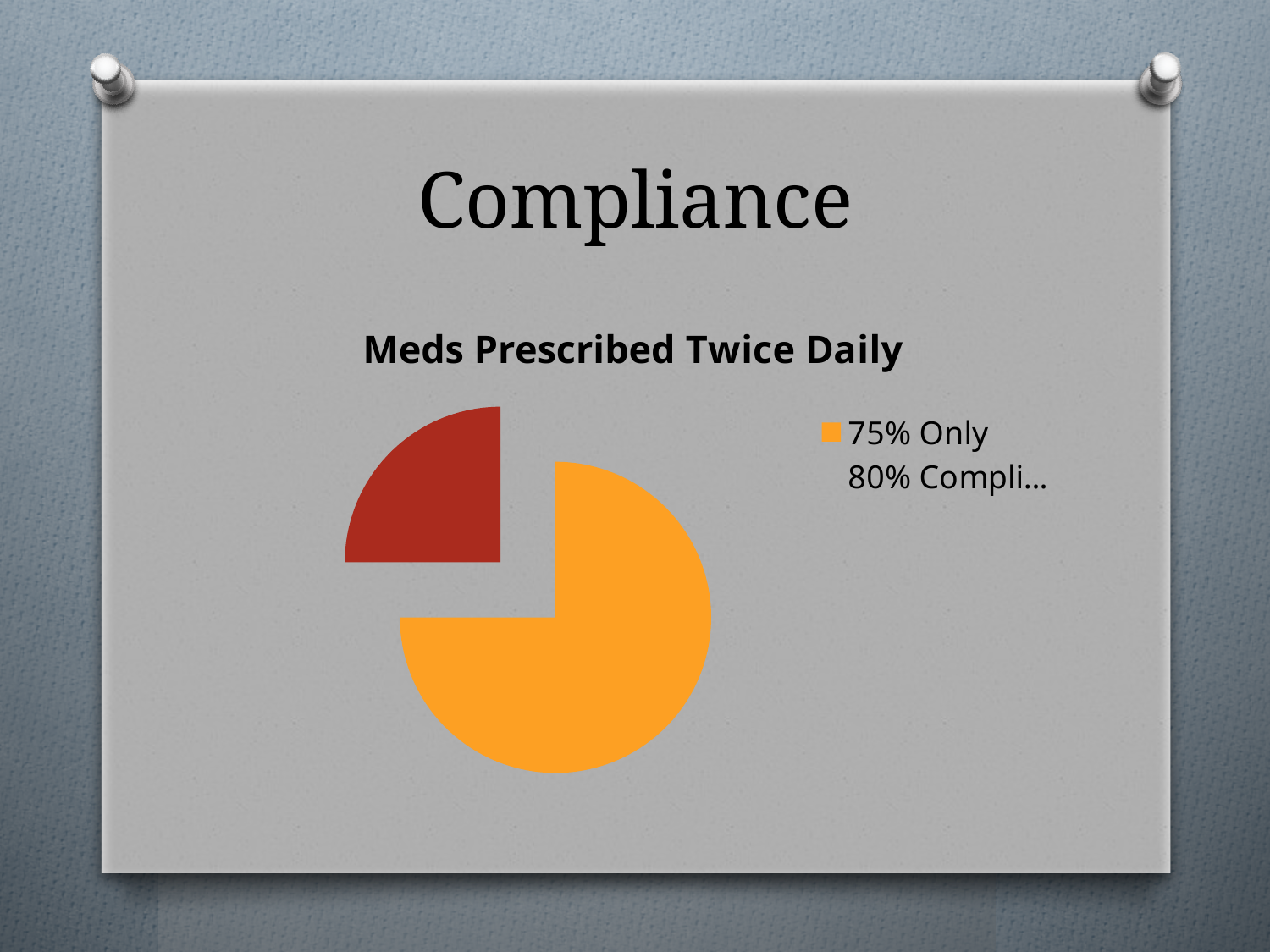
How many entries does the legend of the pie chart list? 1 Which slice of the pie chart is larger, the orange slice or the dark red slice? the orange slice Which slice of the pie chart is the largest? the orange slice Which slice of the pie chart is the smallest? the dark red slice What kind of chart is shown on the slide? pie chart How many slices does the pie chart have? 2 What is the title of the pie chart? Meds Prescribed Twice Daily Which slice of the pie chart is pulled out (exploded) from the rest of the pie? the dark red slice